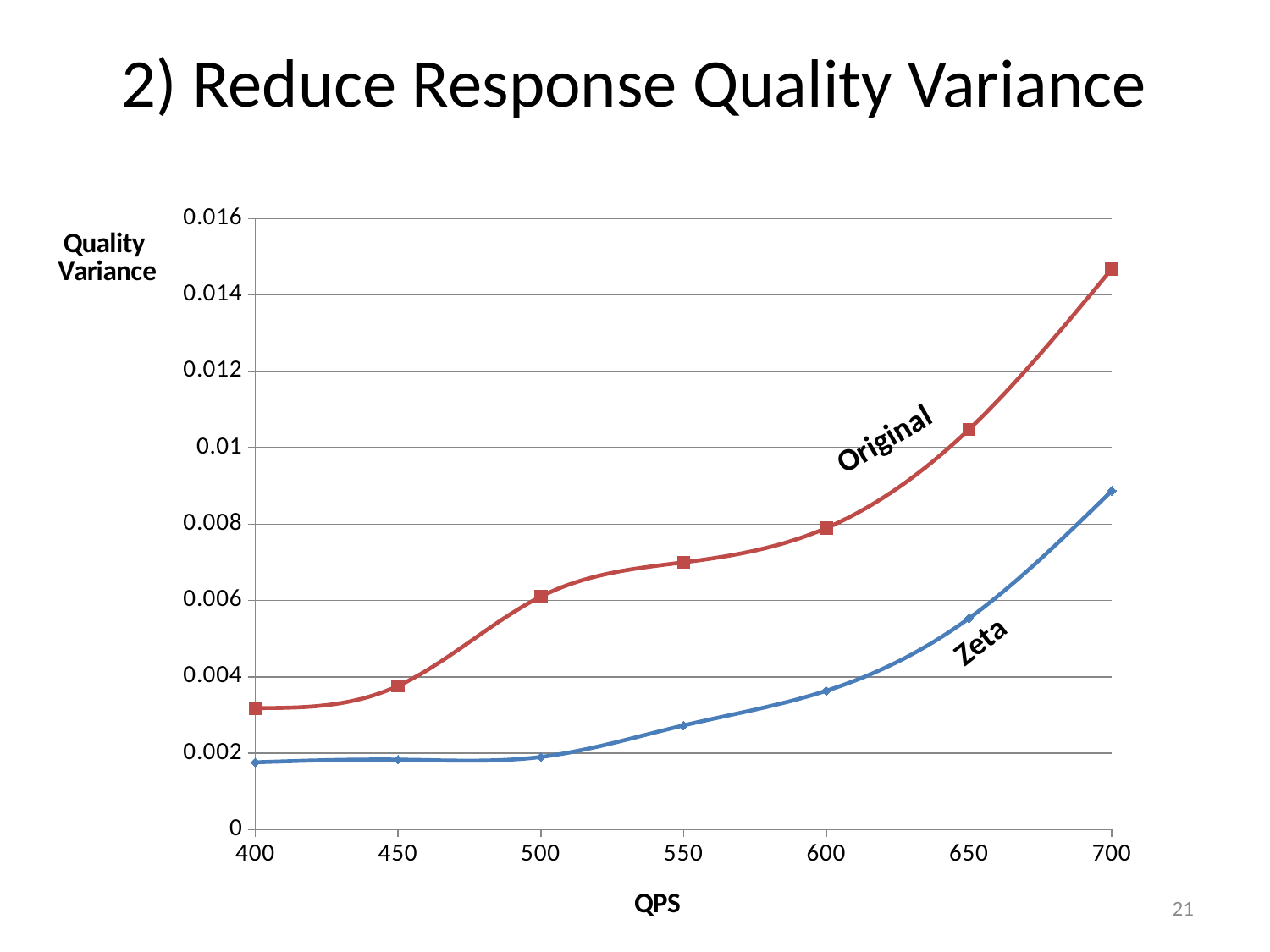
At 700 QPS, which series has the higher quality variance, Original or Zeta? Original How many QPS values are plotted along the x axis? 7 What kind of chart is shown on the slide? line chart How many series are plotted on the chart? 2 Is the Original value at 700 QPS greater or less than 0.014? greater Is the Zeta value at 400 QPS greater or less than 0.002? less Is the Zeta value at 600 QPS greater or less than 0.004? less What are the names of the two series plotted on the chart? Original and Zeta What is the label of the x axis? QPS Does the quality variance for the Original series rise or fall as QPS increases from 400 to 700? rise